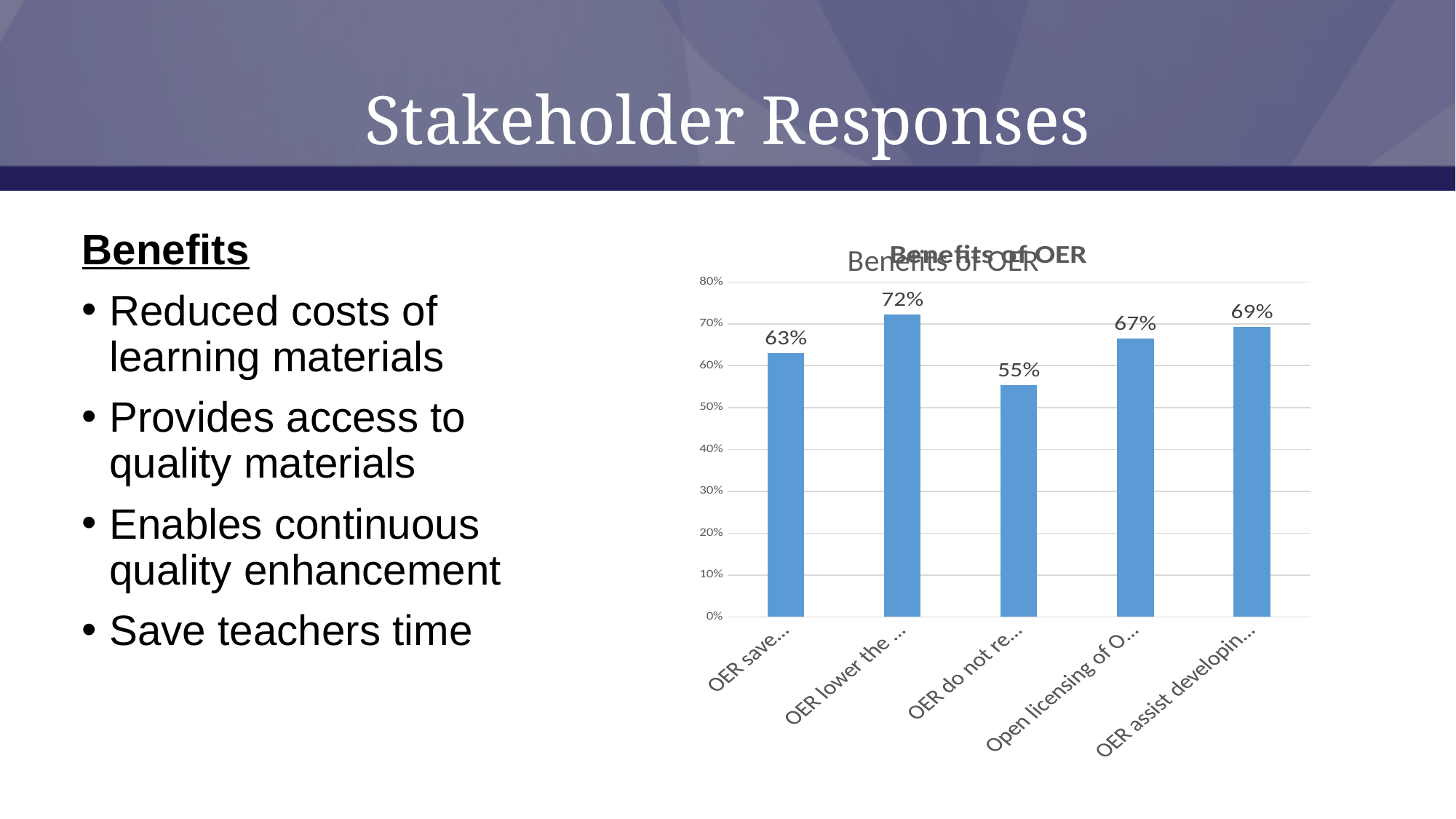
How many bars are plotted in the chart? 5 What is the value of the first bar (labelled "OER save...")? 63% What is the difference between the highest value (72%) and the lowest value (55%)? 17% What type of chart is shown on the slide? bar chart What is the value of the fourth bar (labelled "Open licensing of O...")? 67% What is the value of the fifth bar (labelled "OER assist developin...")? 69% What is the value of the third bar (labelled "OER do not re...")? 55% What is the value of the second bar (labelled "OER lower the ...")? 72% Which bar has the highest value? OER lower the ... (second bar), 72% Which bar has the lowest value? OER do not re... (third bar), 55% Which is larger, the value for the first bar ("OER save...") or the fourth bar ("Open licensing of O...")? Open licensing of O... (67%) What is the title of the chart? Benefits of OER